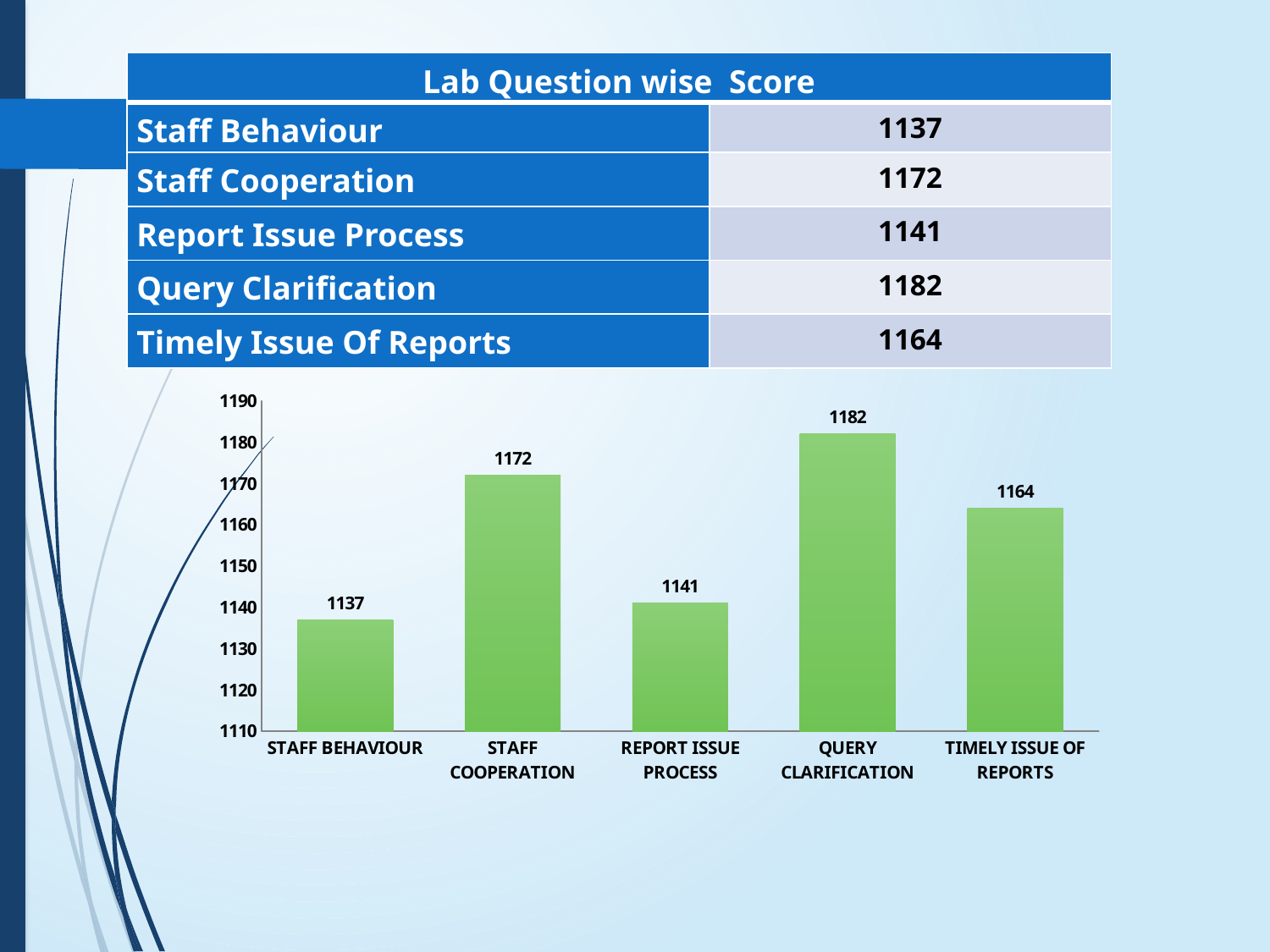
What is the value for Query Clarification in the bar chart? 1182 What is the difference between the values for Staff Cooperation and Report Issue Process? 31 What is the value for Staff Behaviour in the bar chart? 1137 How many categories are shown in the bar chart? 5 What is the difference between the values for Query Clarification and Staff Behaviour? 45 What is the title of the table above the chart? Lab Question wise Score Which category has the highest value in the bar chart? Query Clarification What is the value for Timely Issue Of Reports in the bar chart? 1164 Which is larger, the value for Staff Cooperation or the value for Timely Issue Of Reports? Staff Cooperation Which category has the lowest value in the bar chart? Staff Behaviour Is the value for Report Issue Process greater or less than 1150? less What kind of chart is shown on the slide? bar chart